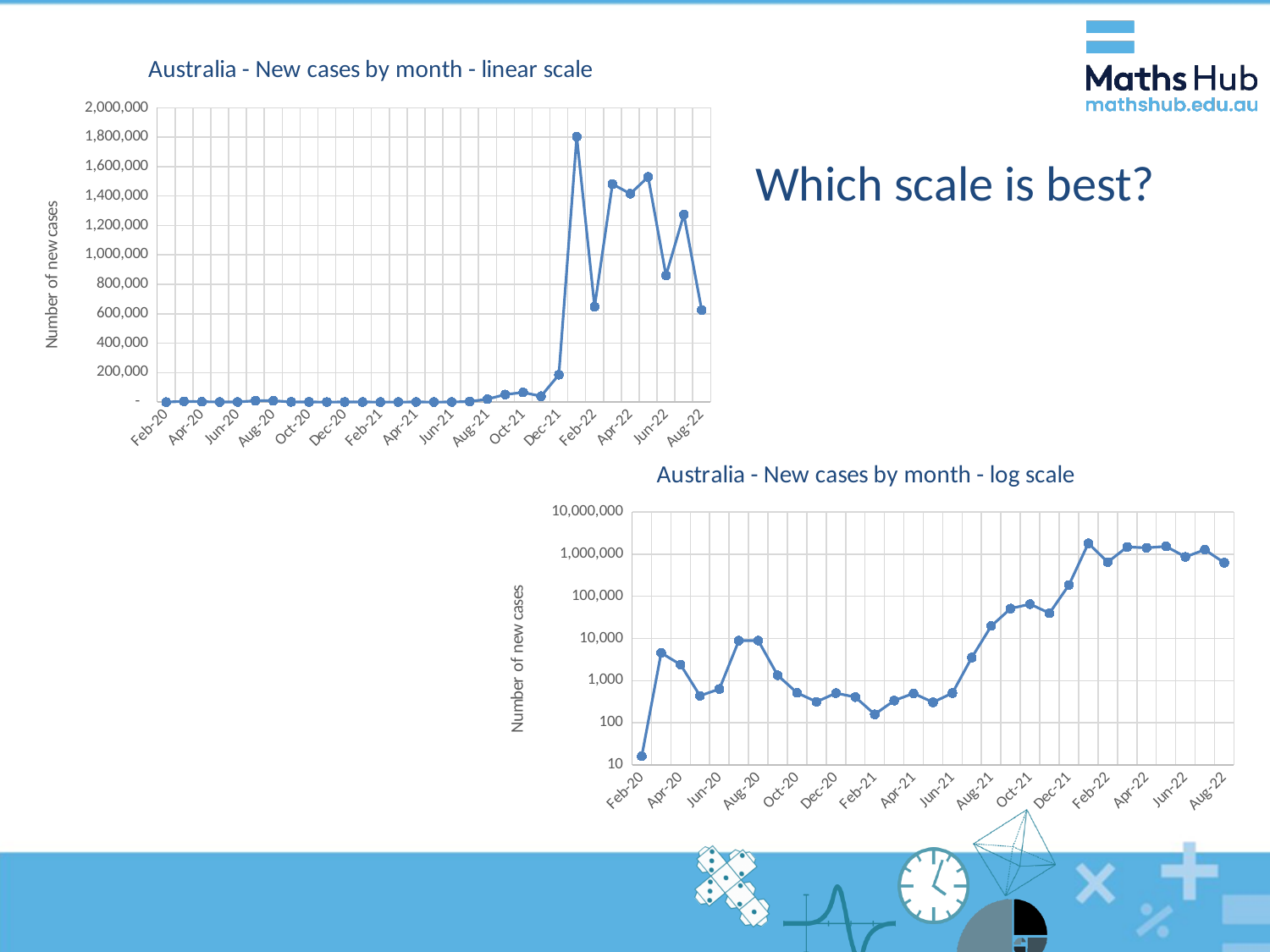
In the 'Australia - New cases by month - linear scale' chart, is the value for Aug-22 greater or less than 800,000? less What is the y-axis label on the 'Australia - New cases by month - log scale' chart? Number of new cases In the 'Australia - New cases by month - log scale' chart, which month has the lowest value? Feb-20 In the 'Australia - New cases by month - linear scale' chart, is the value for Apr-22 greater or less than 1,000,000? greater In the 'Australia - New cases by month - linear scale' chart, which is larger, the value for Apr-22 or the value for Aug-22? Apr-22 In the 'Australia - New cases by month - log scale' chart, is the value for Apr-20 greater or less than 1,000? greater What type of chart is the 'Australia - New cases by month - linear scale' chart? line chart What is the highest tick value shown on the y-axis of the 'Australia - New cases by month - log scale' chart? 10,000,000 In the 'Australia - New cases by month - log scale' chart, do the values rise or fall from Jun-21 to Dec-21? rise